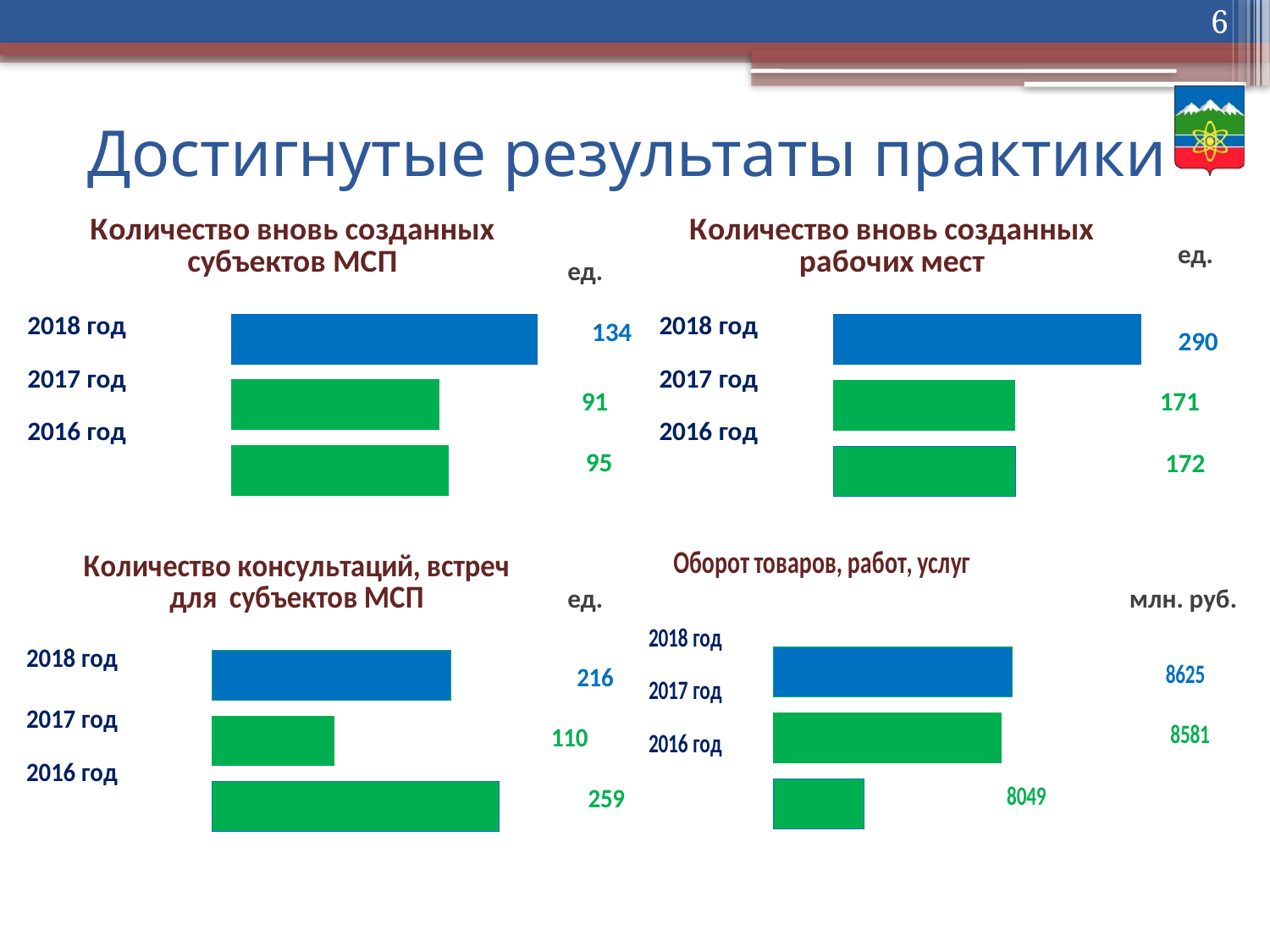
In the chart 'Количество вновь созданных субъектов МСП', which year has the highest value? 2018 год In the chart 'Количество вновь созданных субъектов МСП', what is the value for 2018 год? 134 In the chart 'Количество консультаций, встреч для субъектов МСП', is the value for 2016 год larger or smaller than the value for 2018 год? larger In the chart 'Количество вновь созданных рабочих мест', what is the value for 2016 год? 172 In the chart 'Количество консультаций, встреч для субъектов МСП', what is the value for 2017 год? 110 In the chart 'Количество консультаций, встреч для субъектов МСП', which year has the lowest value? 2017 год In the chart 'Количество вновь созданных рабочих мест', which year has the highest value? 2018 год In the chart 'Оборот товаров, работ, услуг', what is the value for 2018 год? 8625 What unit is shown for the chart 'Оборот товаров, работ, услуг'? млн. руб. In the chart 'Количество вновь созданных рабочих мест', how many years are shown? 3 In the chart 'Количество вновь созданных субъектов МСП', what is the difference between the values for 2018 год and 2017 год? 43 In the chart 'Оборот товаров, работ, услуг', what is the difference between the values for 2017 год and 2016 год? 532